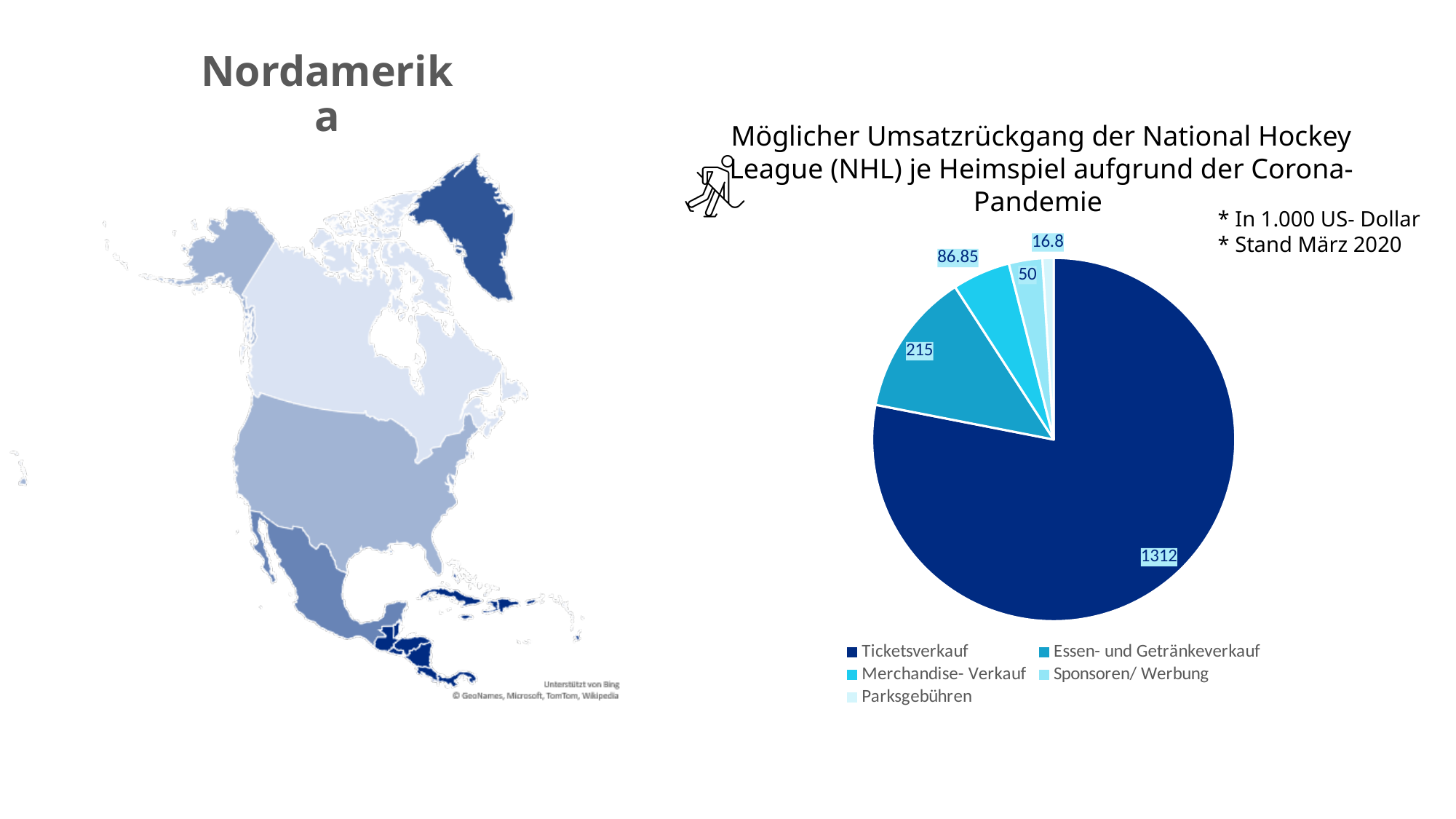
How many categories does the pie chart show? 5 In the pie chart, what is the difference between Ticketsverkauf and Essen- und Getränkeverkauf? 1097 In the pie chart, which category has the largest slice? Ticketsverkauf In the pie chart, what is the value for Ticketsverkauf? 1312 In the pie chart, what is the difference between Sponsoren/ Werbung and Parksgebühren? 33.2 In the pie chart, which is larger, Merchandise- Verkauf or Sponsoren/ Werbung? Merchandise- Verkauf In the pie chart, what is the value for Merchandise- Verkauf? 86.85 What type of chart is shown on the right side of the slide? Pie chart In the pie chart, what is the value for Essen- und Getränkeverkauf? 215 In the pie chart, which category has the smallest slice? Parksgebühren According to the note next to the pie chart, in what unit are the values given? In 1.000 US- Dollar In the pie chart, what is the value for Parksgebühren? 16.8